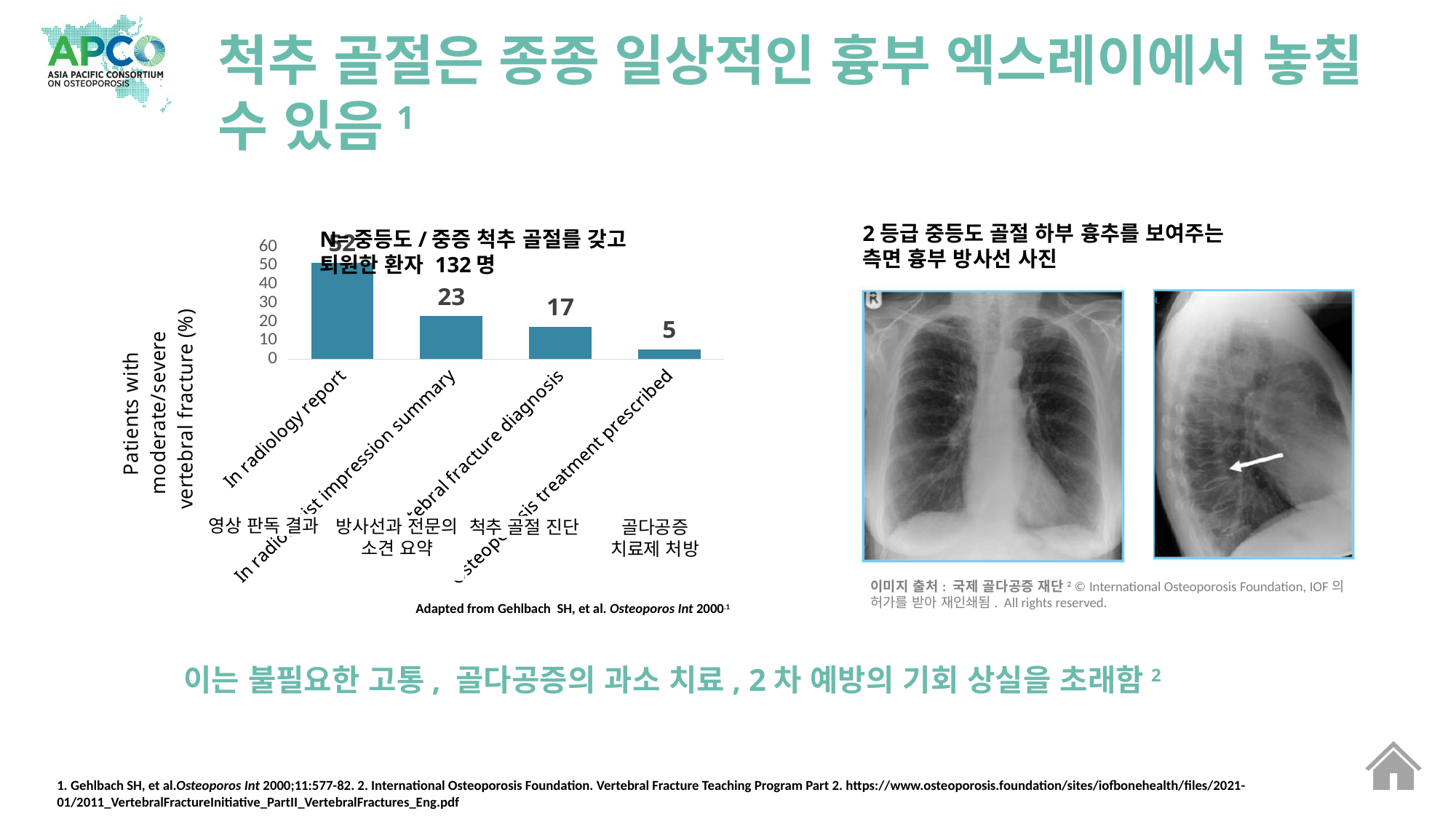
Which category has the highest value? In radiology report What is the value for 'In radiologist impression summary'? 23 What is the difference between the values for 'In radiology report' and 'In radiologist impression summary'? 29 Which category has the lowest value? Osteoporosis treatment prescribed What is the value for 'Osteoporosis treatment prescribed'? 5 What is the value for 'In radiology report'? 52 Do the values rise or fall from left to right across the categories? fall What is the label of the vertical axis of the chart? Patients with moderate/severe vertebral fracture (%) What is the value for 'Vertebral fracture diagnosis'? 17 What kind of chart is shown on the slide? bar chart Which is larger, the value for 'Vertebral fracture diagnosis' or the value for 'Osteoporosis treatment prescribed'? Vertebral fracture diagnosis How many bars (categories) does the chart show? 4